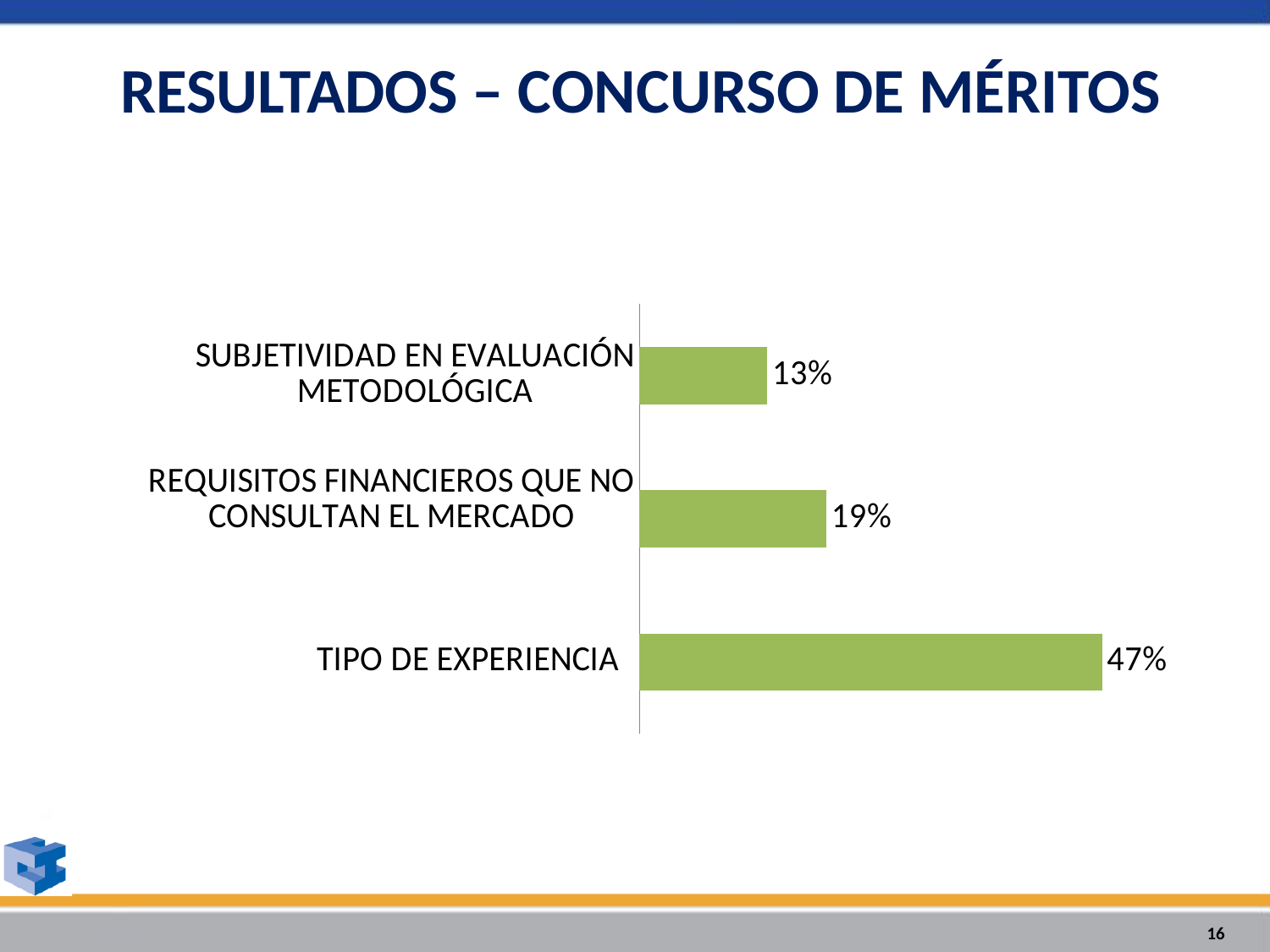
Which category has the lowest value? SUBJETIVIDAD EN EVALUACIÓN METODOLÓGICA What colour are the bars in the chart? Green What kind of chart is shown on the slide? Bar chart What is the value for SUBJETIVIDAD EN EVALUACIÓN METODOLÓGICA? 13% What is the value for TIPO DE EXPERIENCIA? 47% What is the difference between the values for TIPO DE EXPERIENCIA and REQUISITOS FINANCIEROS QUE NO CONSULTAN EL MERCADO? 28% Which category has the highest value? TIPO DE EXPERIENCIA How many categories are shown in the chart? 3 What is the difference between the values for REQUISITOS FINANCIEROS QUE NO CONSULTAN EL MERCADO and SUBJETIVIDAD EN EVALUACIÓN METODOLÓGICA? 6% What is the value for REQUISITOS FINANCIEROS QUE NO CONSULTAN EL MERCADO? 19% What is the title of the slide containing the chart? RESULTADOS – CONCURSO DE MÉRITOS Which is larger, the value for SUBJETIVIDAD EN EVALUACIÓN METODOLÓGICA or the value for REQUISITOS FINANCIEROS QUE NO CONSULTAN EL MERCADO? REQUISITOS FINANCIEROS QUE NO CONSULTAN EL MERCADO